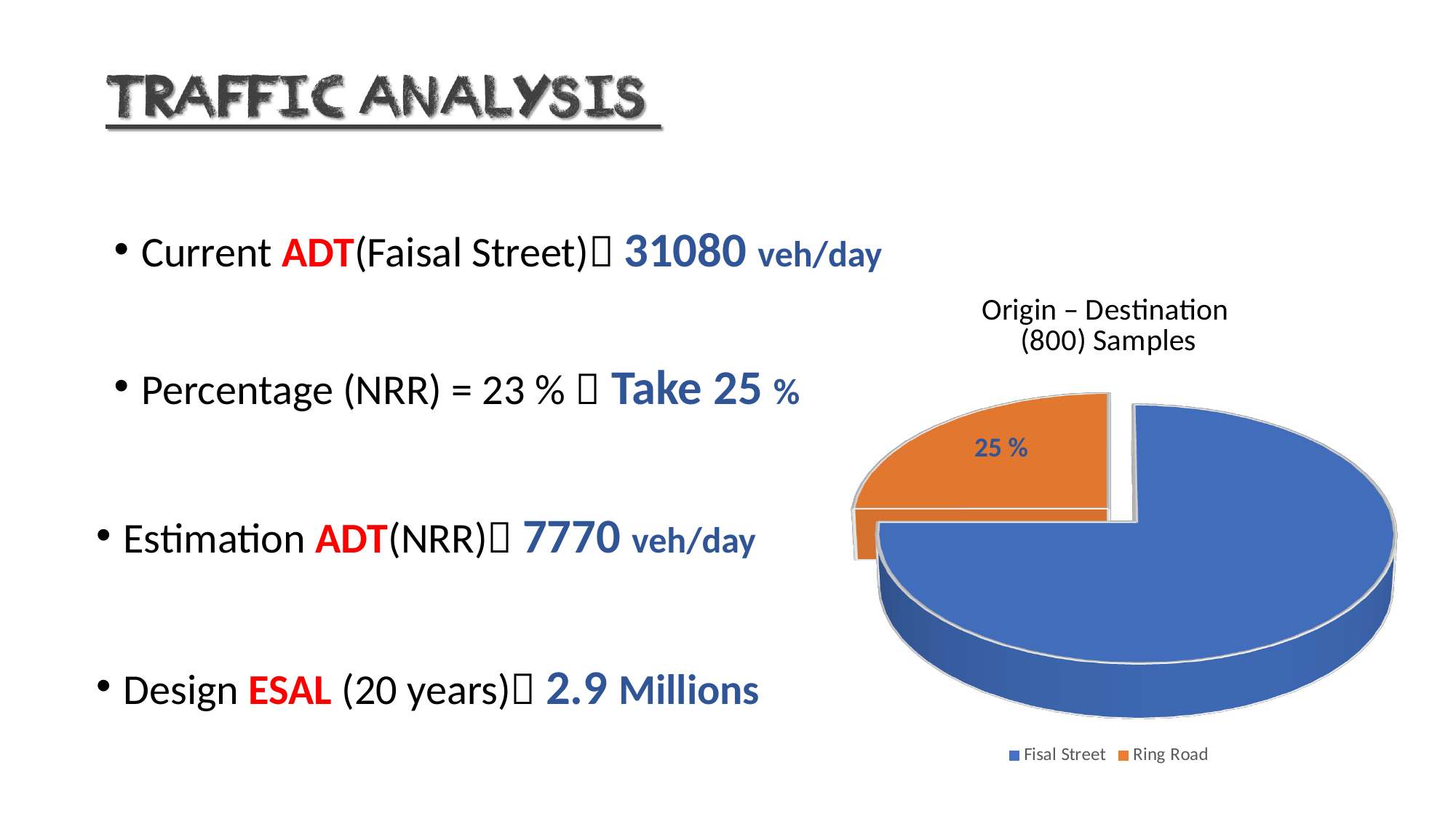
What colour is the Ring Road slice in the pie chart? Orange How many slices does the pie chart have? 2 What share of the pie does Ring Road represent? 25 % What kind of chart is shown on the slide? Pie chart What percentage is labelled on the Ring Road slice of the pie chart? 25 % Which is larger in the pie chart, Fisal Street or Ring Road? Fisal Street Which slice of the pie chart is the largest? Fisal Street What is the title of the pie chart? Origin – Destination (800) Samples Which slice of the pie chart is the smallest? Ring Road How many entries does the pie chart's legend list? 2